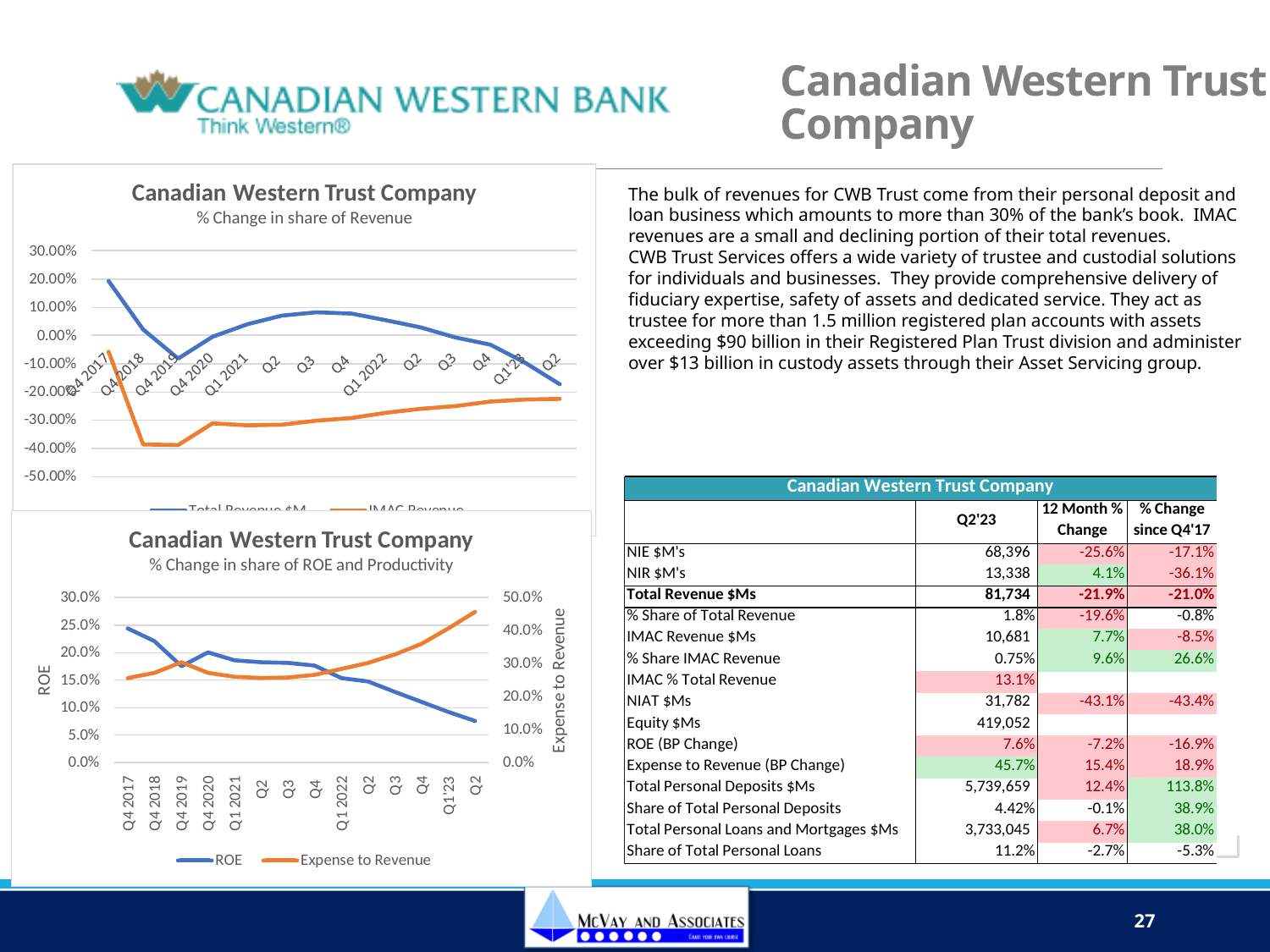
How many series does the legend of the '% Change in share of ROE and Productivity' chart list? 2 What kind of chart is the 'Canadian Western Trust Company – % Change in share of ROE and Productivity' chart? Line chart In the '% Change in share of Revenue' chart, which series has the higher value at Q4 2017, Total Revenue or IMAC Revenue? Total Revenue In the '% Change in share of ROE and Productivity' chart, does ROE rise or fall from Q1 2022 to the final Q2 point? Fall What is the label on the right-hand vertical axis of the '% Change in share of ROE and Productivity' chart? Expense to Revenue In the '% Change in share of ROE and Productivity' chart, does Expense to Revenue rise or fall from Q4 2020 to the final Q2 point? Rise In the '% Change in share of ROE and Productivity' chart, is the ROE value for Q4 2017 greater or less than 20.0%? greater In the '% Change in share of ROE and Productivity' chart, at which period is ROE highest? Q4 2017 In the '% Change in share of Revenue' chart, is the IMAC Revenue value for Q4 2018 greater or less than -30.00%? less How many time periods are plotted along the x axis of the '% Change in share of ROE and Productivity' chart? 14 In the '% Change in share of ROE and Productivity' chart, is the Expense to Revenue value at the final Q2 point greater or less than 40.0%? greater